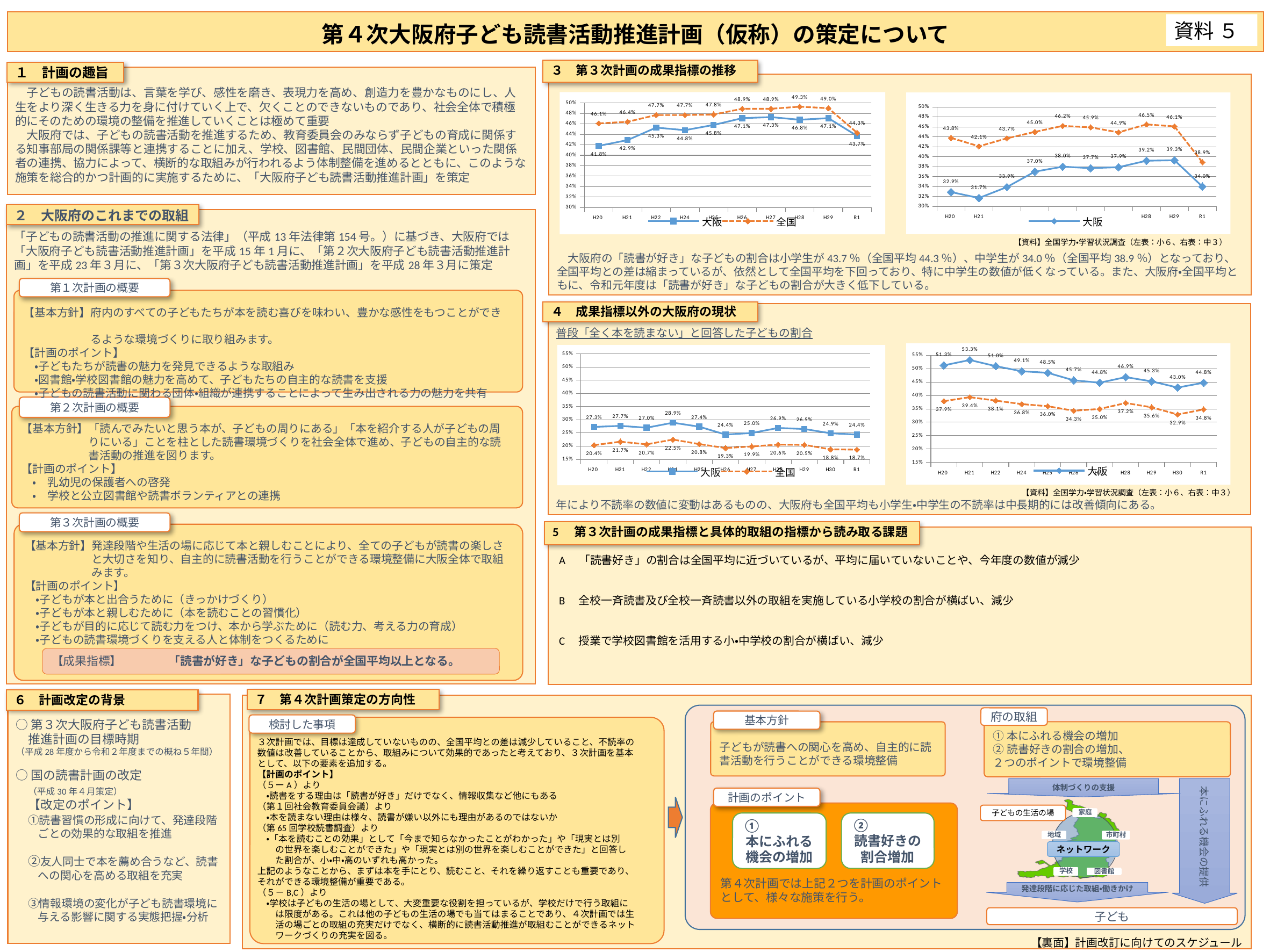
In the right chart of section 4 (普段「全く本を読まない」と回答した子どもの割合), which year has the highest 大阪 value? H21 In the right chart of section 3 (第３次計画の成果指標の推移), at which year is the 大阪 value lowest? H21 In the right chart of section 3 (第３次計画の成果指標の推移), is the 大阪 value at R1 greater or less than 36%? less In the right chart of section 4 (普段「全く本を読まない」と回答した子どもの割合), which is larger at H30: the 大阪 value or the 全国 value? 大阪 In the left chart of section 4 (普段「全く本を読まない」と回答した子どもの割合), how many years are plotted on the x axis? 11 In the left chart of section 3 (第３次計画の成果指標の推移), what is the value for 大阪 at R1? 43.7% What kind of chart is the left chart in section 4 (普段「全く本を読まない」と回答した子どもの割合)? line chart In the left chart of section 3 (第３次計画の成果指標の推移), what is the value for 全国 at H28? 49.3% In the right chart of section 3 (第３次計画の成果指標の推移), what is the value for 大阪 at H29? 39.3% In the left chart of section 3 (第３次計画の成果指標の推移), how many series does the legend list? 2 In the left chart of section 3 (第３次計画の成果指標の推移), what is the difference between 全国 and 大阪 at H20? 4.3% In the left chart of section 4 (普段「全く本を読まない」と回答した子どもの割合), what is the value for 大阪 at H24? 28.9%